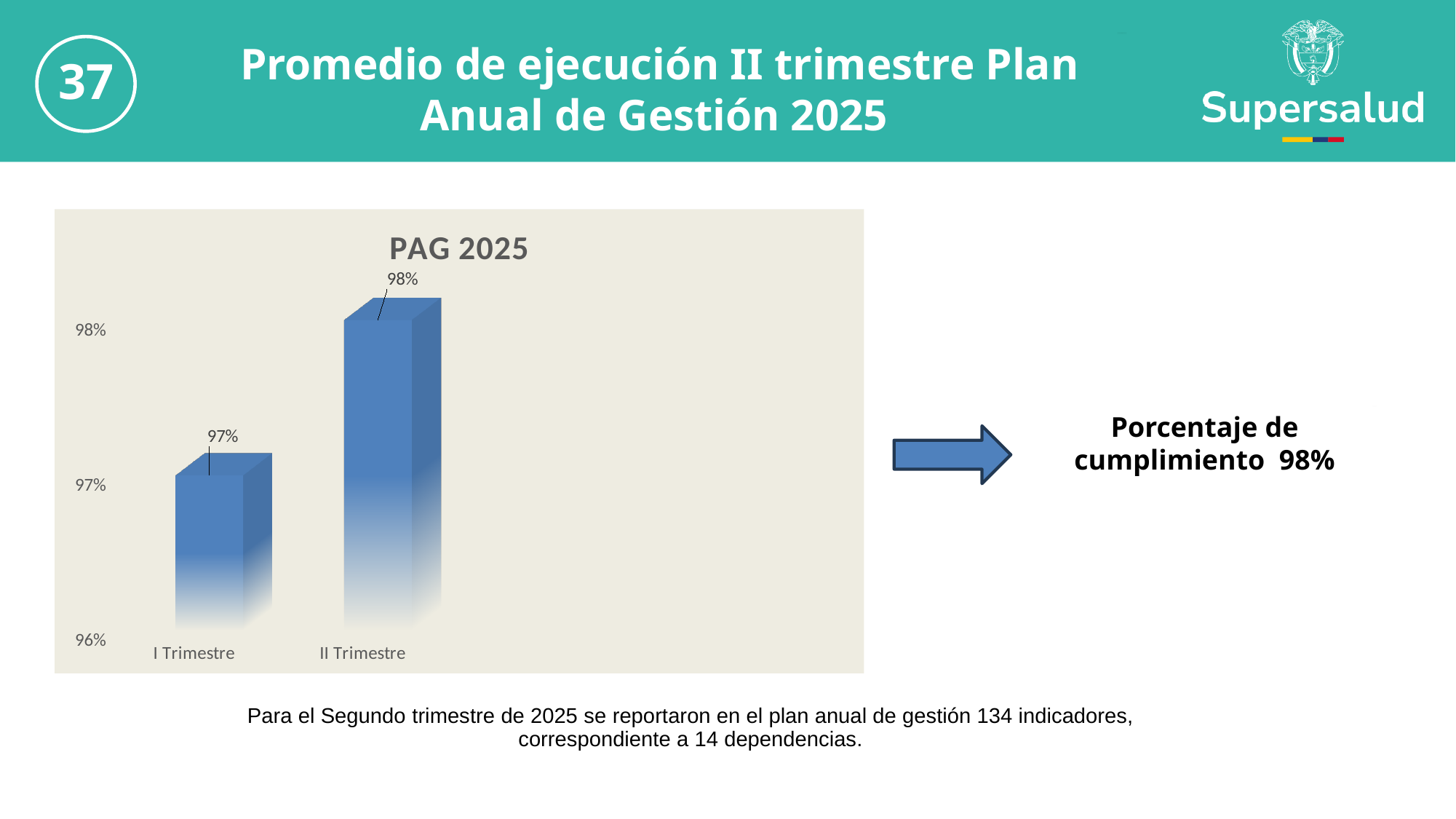
How many categories are shown in the PAG 2025 chart? 2 What is the title of the chart on the slide? PAG 2025 What kind of chart is the PAG 2025 chart? Bar chart What is the difference between the values for II Trimestre and I Trimestre in the PAG 2025 chart? 1% What is the value for I Trimestre in the PAG 2025 chart? 97% Which category has the highest value in the PAG 2025 chart? II Trimestre Do the values rise or fall from I Trimestre to II Trimestre in the PAG 2025 chart? Rise Which category has the lowest value in the PAG 2025 chart? I Trimestre What is the value for II Trimestre in the PAG 2025 chart? 98% Which is larger in the PAG 2025 chart, the value for I Trimestre or II Trimestre? II Trimestre What is the lowest value shown on the vertical axis of the PAG 2025 chart? 96%